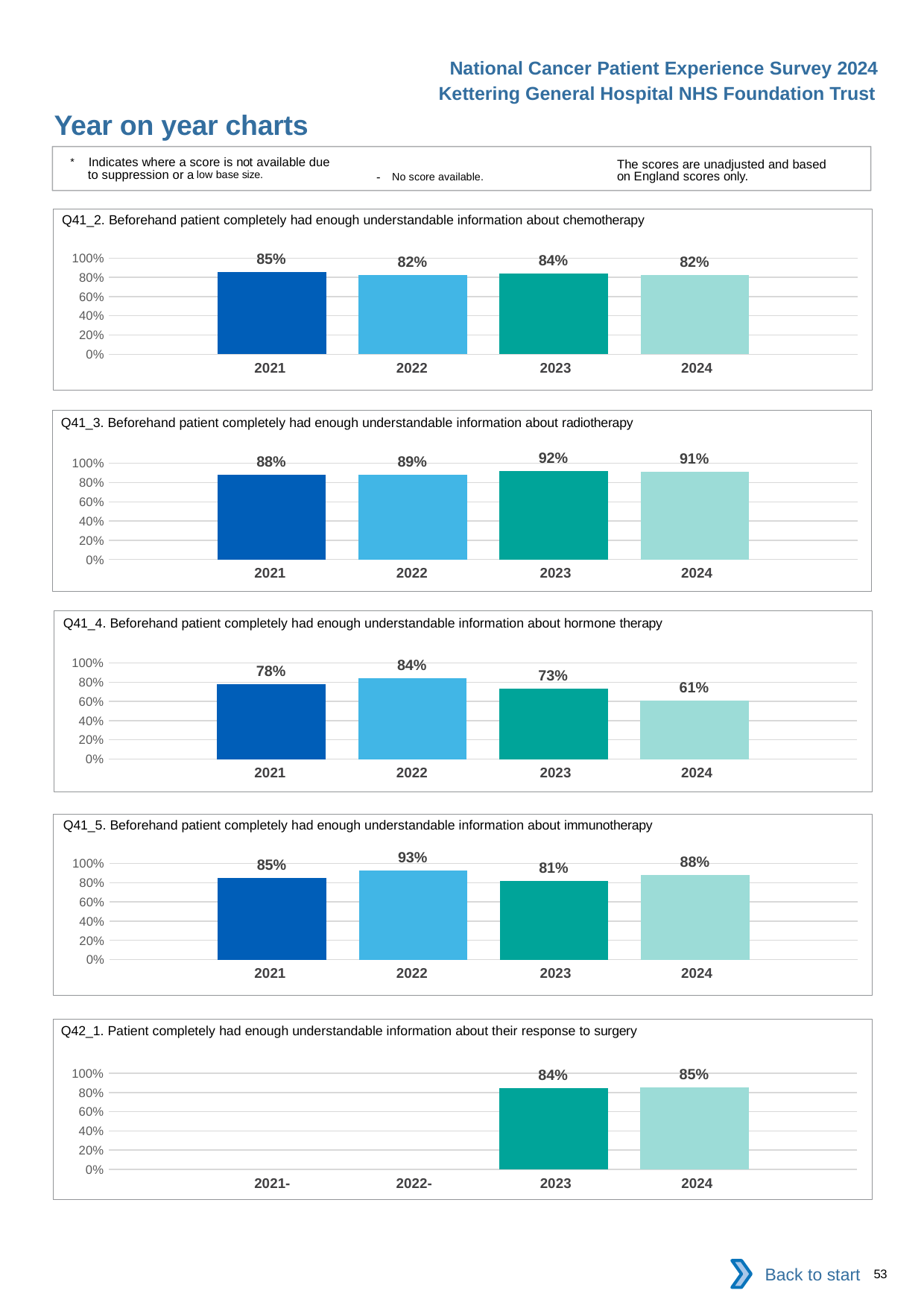
In the Q41_4 hormone therapy chart, what is the difference between the 2022 and 2024 values? 23% In the Q41_3 radiotherapy chart, what is the difference between the 2023 and 2021 values? 4% In the Q41_3 radiotherapy chart, which year has the highest value? 2023 In the Q41_5 immunotherapy chart, what is the value for 2024? 88% In the Q42_1 surgery chart, what is the value for 2023? 84% In the Q41_5 immunotherapy chart, which is larger, the value for 2022 or the value for 2023? 2022 In the Q42_1 surgery chart, how many years have a bar plotted? 2 In the Q41_4 hormone therapy chart, which year has the lowest value? 2024 What kind of chart is the Q41_2 chemotherapy chart? bar chart How many charts are shown on the slide? 5 In the Q41_4 hormone therapy chart, do the values rise or fall from 2022 to 2024? fall In the Q41_2 chemotherapy chart, what is the value for 2021? 85%